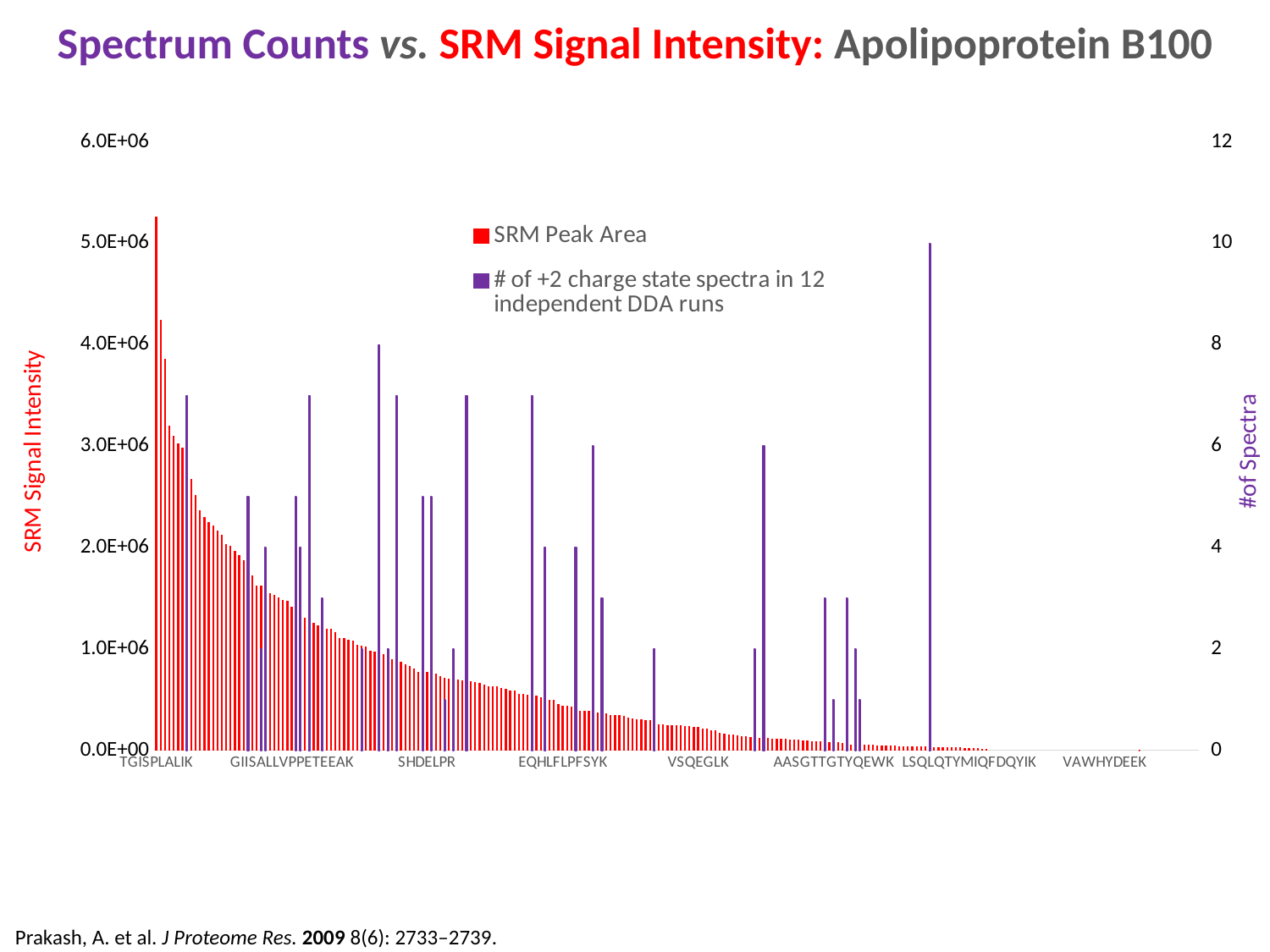
Is the SRM Peak Area value for TGISPLALIK greater or less than 5.0E+06? greater Is the SRM Peak Area value for SHDELPR greater or less than 1.0E+06? less Which has the larger SRM Peak Area value, TGISPLALIK or VAWHYDEEK? TGISPLALIK Is the SRM Peak Area value for GIISALLVPPETEEAK greater or less than 1.0E+06? greater Do the SRM Peak Area values rise or fall from left to right along the x axis? Fall Which has the larger SRM Peak Area value, GIISALLVPPETEEAK or SHDELPR? GIISALLVPPETEEAK What is the title of the chart? Spectrum Counts vs. SRM Signal Intensity: Apolipoprotein B100 Which series is shown in red in the legend? SRM Peak Area How many series does the legend list? 2 What kind of chart is shown on the slide? Bar chart What is the highest value reached by the # of +2 charge state spectra series on the right axis? 10